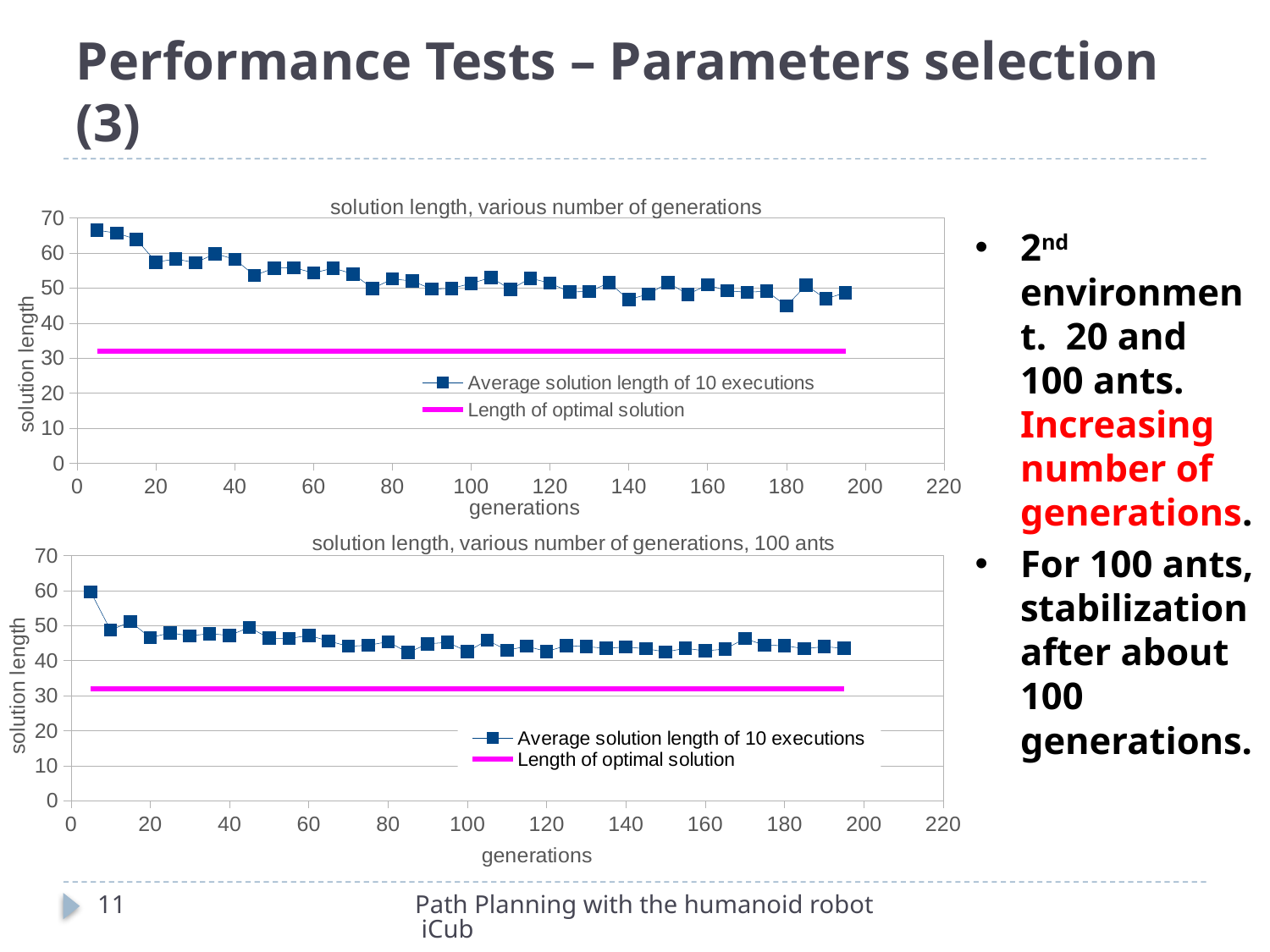
In the top chart, is the average solution length at 180 generations greater or less than 50? less In the top chart, how many series does the legend list? 2 In the top chart, which is larger: the average solution length at 5 generations or at 195 generations? 5 generations What is the title of the bottom chart? solution length, various number of generations, 100 ants In the bottom chart, does the average solution length of 10 executions generally rise or fall as the number of generations increases? fall What kind of chart is the top chart titled "solution length, various number of generations"? line chart In the bottom chart, is the average solution length at 5 generations greater or less than 50? greater In the bottom chart, is the length of the optimal solution greater or less than 40? less In the top chart, does the average solution length of 10 executions generally rise or fall as the number of generations increases? fall In the top chart, what are the two legend entries? Average solution length of 10 executions; Length of optimal solution